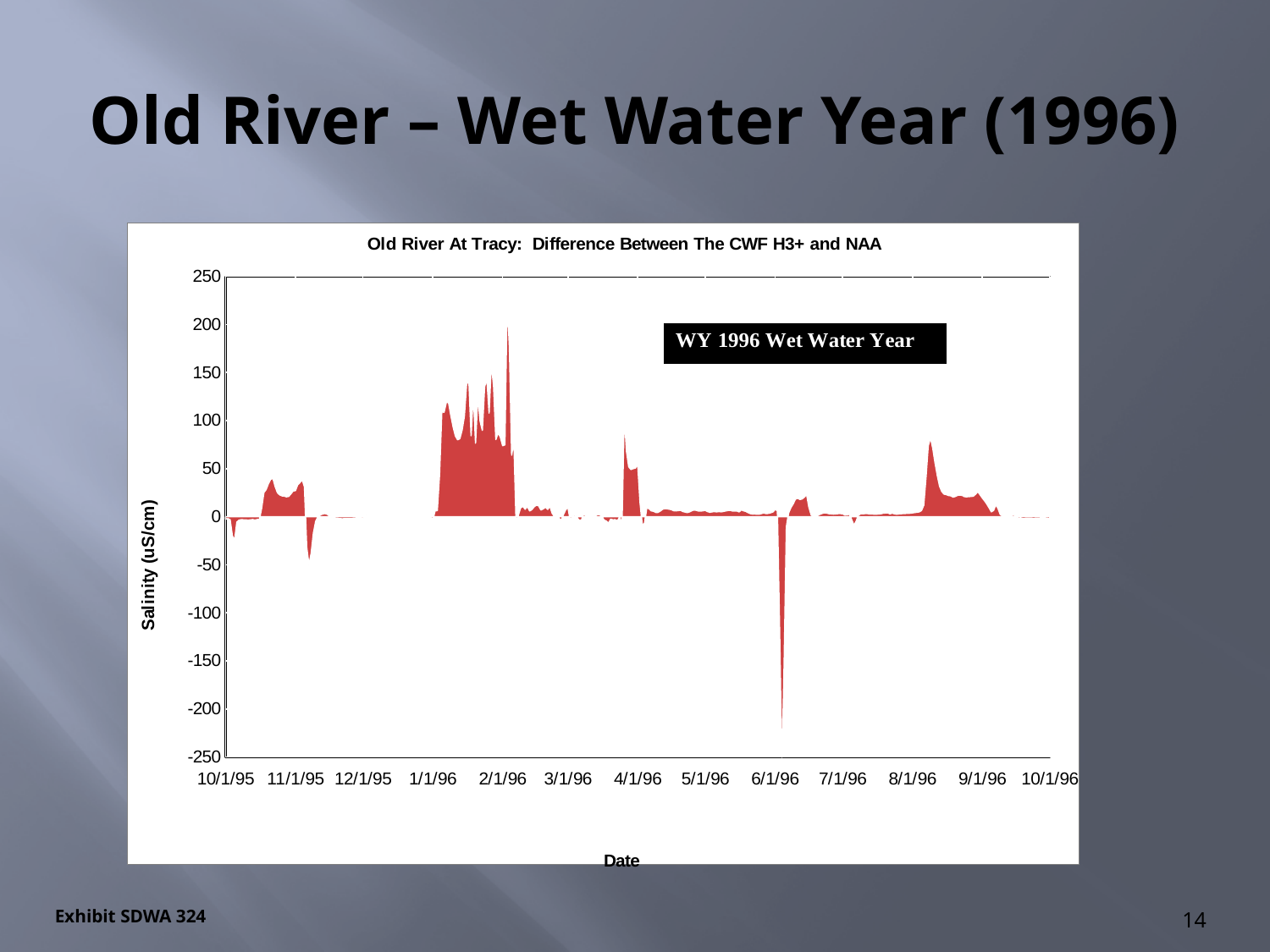
What is the last date shown on the horizontal axis? 10/1/96 Is the lowest dip of the series, occurring shortly after 6/1/96, greater or less than -200? less Is the dip of the series occurring shortly after 11/1/95 greater or less than -100? greater Is the highest peak of the series, occurring just before 2/1/96, greater or less than 150? greater What is the lowest value shown on the vertical axis? -250 What is the title of the chart? Old River At Tracy: Difference Between The CWF H3+ and NAA What is the first date shown on the horizontal axis? 10/1/95 What is the highest value shown on the vertical axis? 250 What is the label of the vertical axis? Salinity (uS/cm) What kind of chart is shown on the slide? area chart How many date tick labels are shown on the horizontal axis? 13